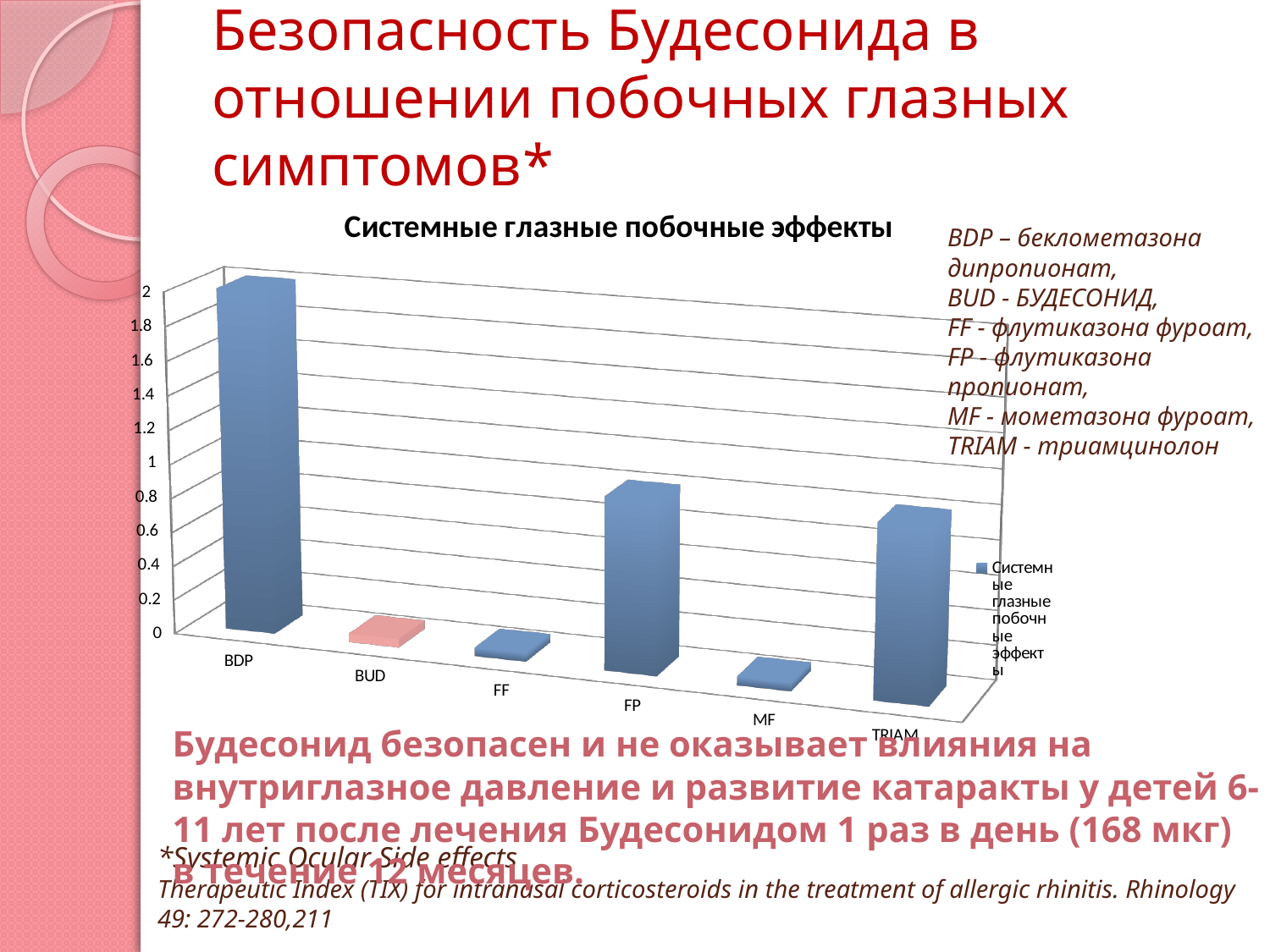
How many series does the chart legend list? 1 Which is larger, the value for BDP or the value for FP? BDP Is the value for TRIAM greater or less than 0.4? greater Is the value for BDP greater or less than 1? greater Which category has the highest value in the chart? BDP What is the title of the chart? Системные глазные побочные эффекты Is the value for MF greater or less than 0.4? less What kind of chart is shown on the slide? Bar chart Which bar in the chart is coloured differently (pink) from the others? BUD How many categories are shown on the x axis of the chart? 6 Which is larger, the value for TRIAM or the value for FF? TRIAM